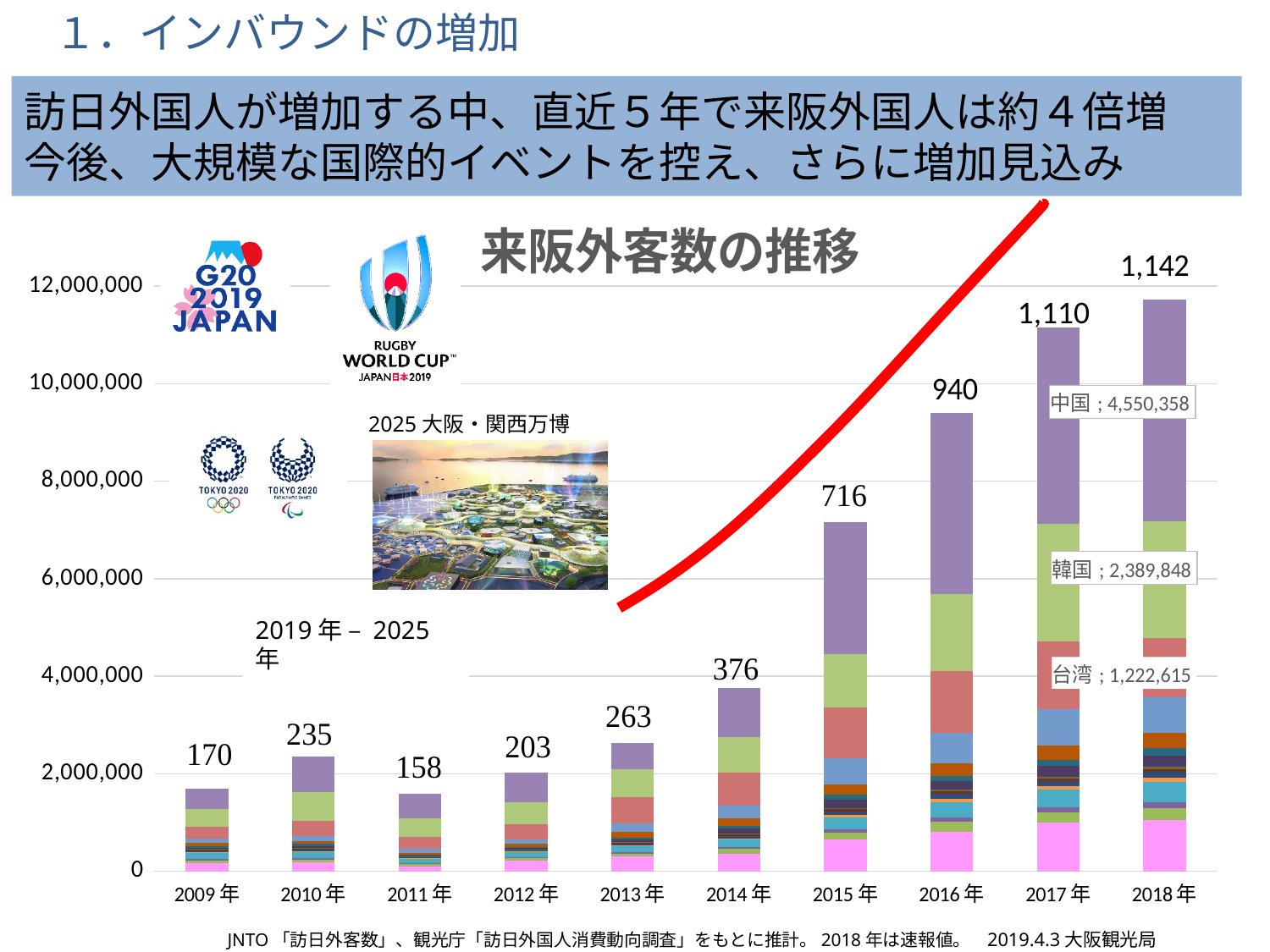
What value is shown for 韓国 in the 2018年 bar? 2,389,848 Which year has the lowest labeled total in the chart? 2011年 What value is shown for 中国 in the 2018年 bar? 4,550,358 What is the total value labeled above the bar for 2009年? 170 Which year has the highest labeled total in the chart? 2018年 What is the difference between the labeled totals for 2018年 and 2017年? 32 Which is larger, the labeled total for 2015年 or for 2016年? 2016年 How many years are shown on the x axis of the chart? 10 What is the title of the chart? 来阪外客数の推移 What is the total value labeled above the bar for 2018年? 1,142 What is the total value labeled above the bar for 2014年? 376 What kind of chart is shown on the slide? stacked bar chart